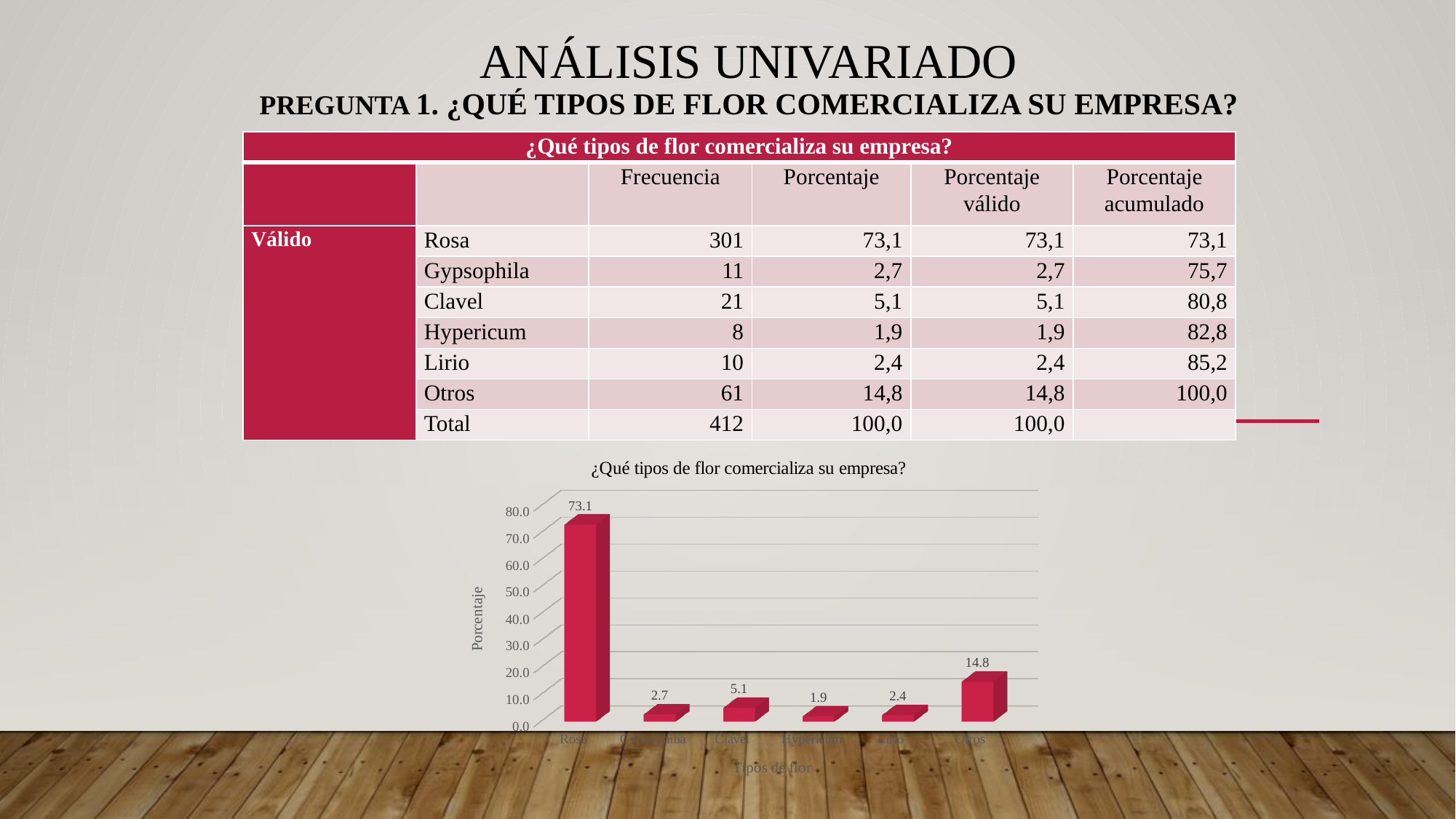
What type of chart is shown on the slide? bar chart Which has a larger value in the chart, Clavel or Lirio? Clavel What is the difference between the chart values for Rosa and Otros? 58.3 Which flower type has the lowest bar in the chart? Hypericum What is the percentage value shown for Clavel in the chart? 5.1 How many flower type categories are plotted in the chart? 6 What is the label of the vertical axis of the chart? Porcentaje Which flower type has the highest bar in the chart? Rosa Is the value for Otros in the chart greater or less than 10.0? greater What is the percentage value shown for Otros in the chart? 14.8 What is the percentage value shown for Rosa in the chart? 73.1 What is the percentage value shown for Hypericum in the chart? 1.9